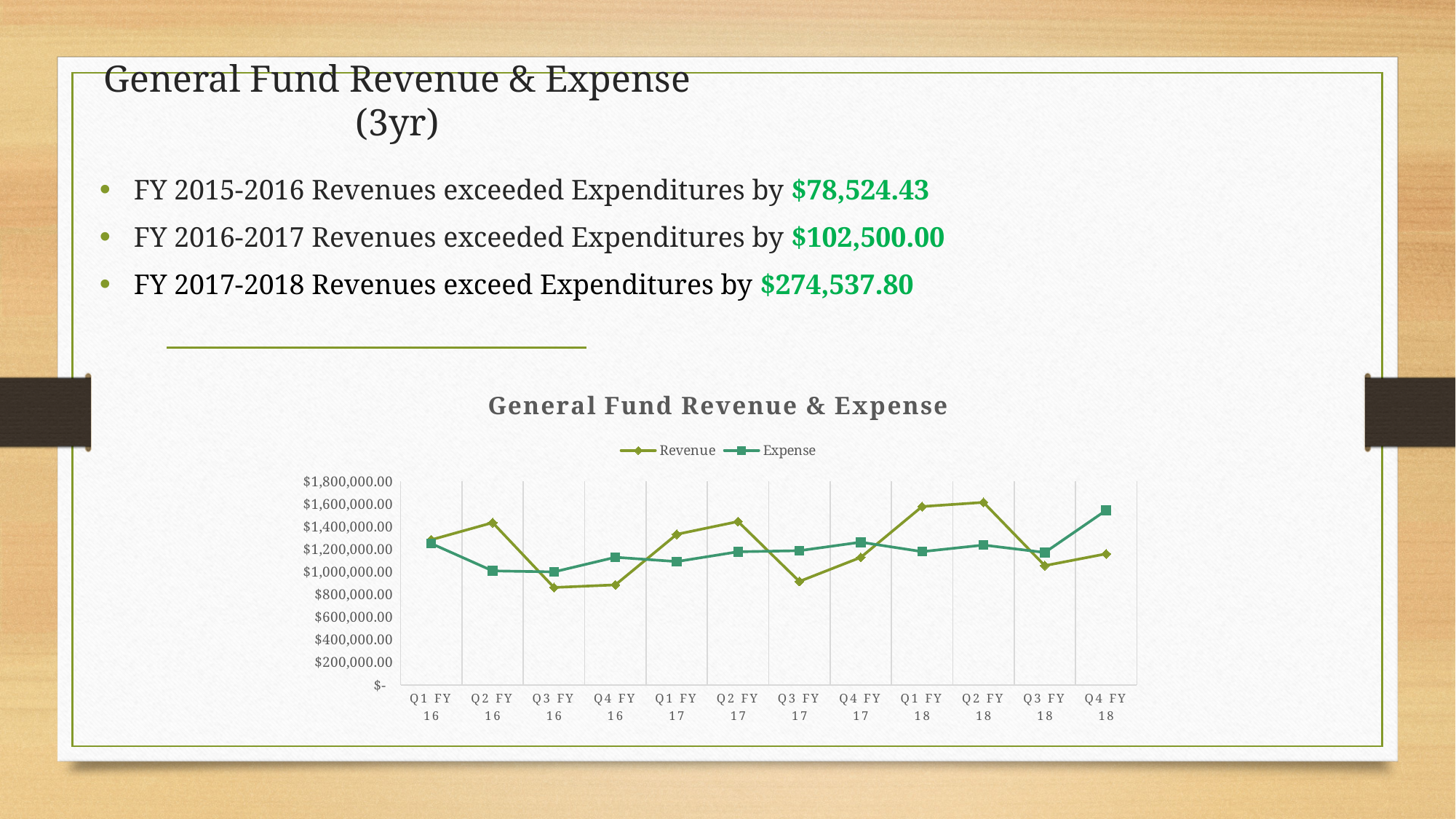
Is the Revenue value for Q1 FY 18 greater or less than $1,400,000.00? greater What is the title of the chart? General Fund Revenue & Expense What kind of chart is shown on the slide? line chart In which quarter is the Expense value highest? Q4 FY 18 How many quarters are plotted along the x axis of the chart? 12 Is the Expense value for Q4 FY 18 greater or less than $1,400,000.00? greater Is the Revenue value for Q3 FY 16 greater or less than $1,000,000.00? less Does the Expense line rise or fall from Q3 FY 18 to Q4 FY 18? rise In Q3 FY 16, which is larger, Revenue or Expense? Expense How many series does the chart legend list? 2 Which series is drawn with square markers in the chart? Expense In Q2 FY 18, which is larger, Revenue or Expense? Revenue